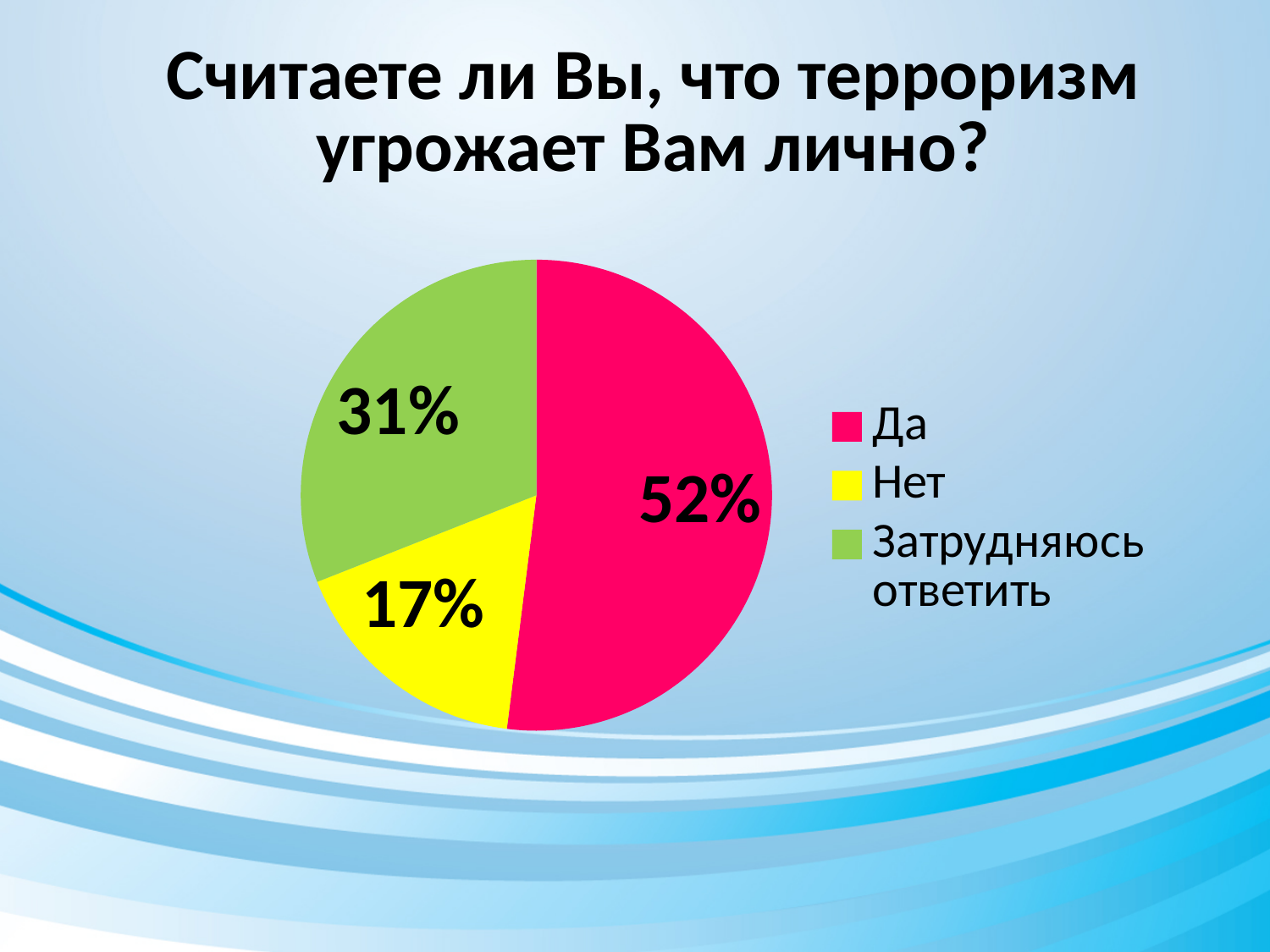
Which answer has the smallest share of the pie? Нет What percentage of respondents answered "Затрудняюсь ответить"? 31% Which answer has the largest share of the pie? Да Which is larger, the share for "Нет" or the share for "Затрудняюсь ответить"? Затрудняюсь ответить What kind of chart is shown on the slide? Pie chart What is the difference in percentage points between "Затрудняюсь ответить" and "Нет"? 14 What is the difference in percentage points between "Да" and "Нет"? 35 What is the title of the chart? Считаете ли Вы, что терроризм угрожает Вам лично? What percentage of respondents answered "Нет"? 17% How many slices does the pie chart have? 3 What colour is the slice for "Да"? Pink (magenta) What percentage of respondents answered "Да"? 52%